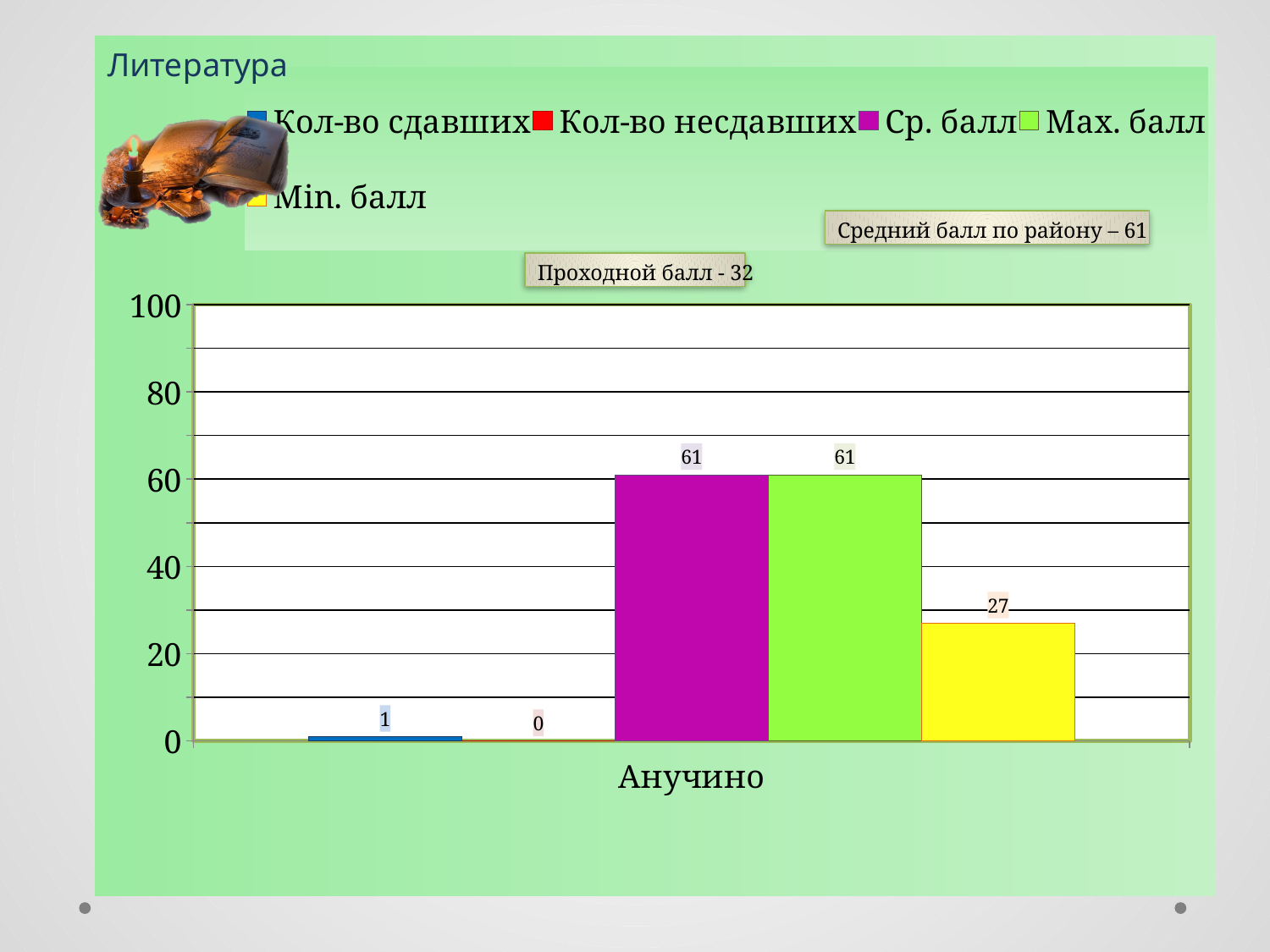
What is the value of Кол-во несдавших for Анучино? 0 How many categories are shown on the x axis? 1 What kind of chart is shown on the slide? bar chart Which series has the lowest value for Анучино? Кол-во несдавших What is the value of Ср. балл for Анучино? 61 Is the value of Min. балл for Анучино greater or less than 40? less What is the value of Min. балл for Анучино? 27 How many series does the legend list? 5 Which is larger for Анучино, Ср. балл or Min. балл? Ср. балл What is the difference between Max. балл and Min. балл for Анучино? 34 What is the value of Кол-во сдавших for Анучино? 1 What colour is the bar for Max. балл? green